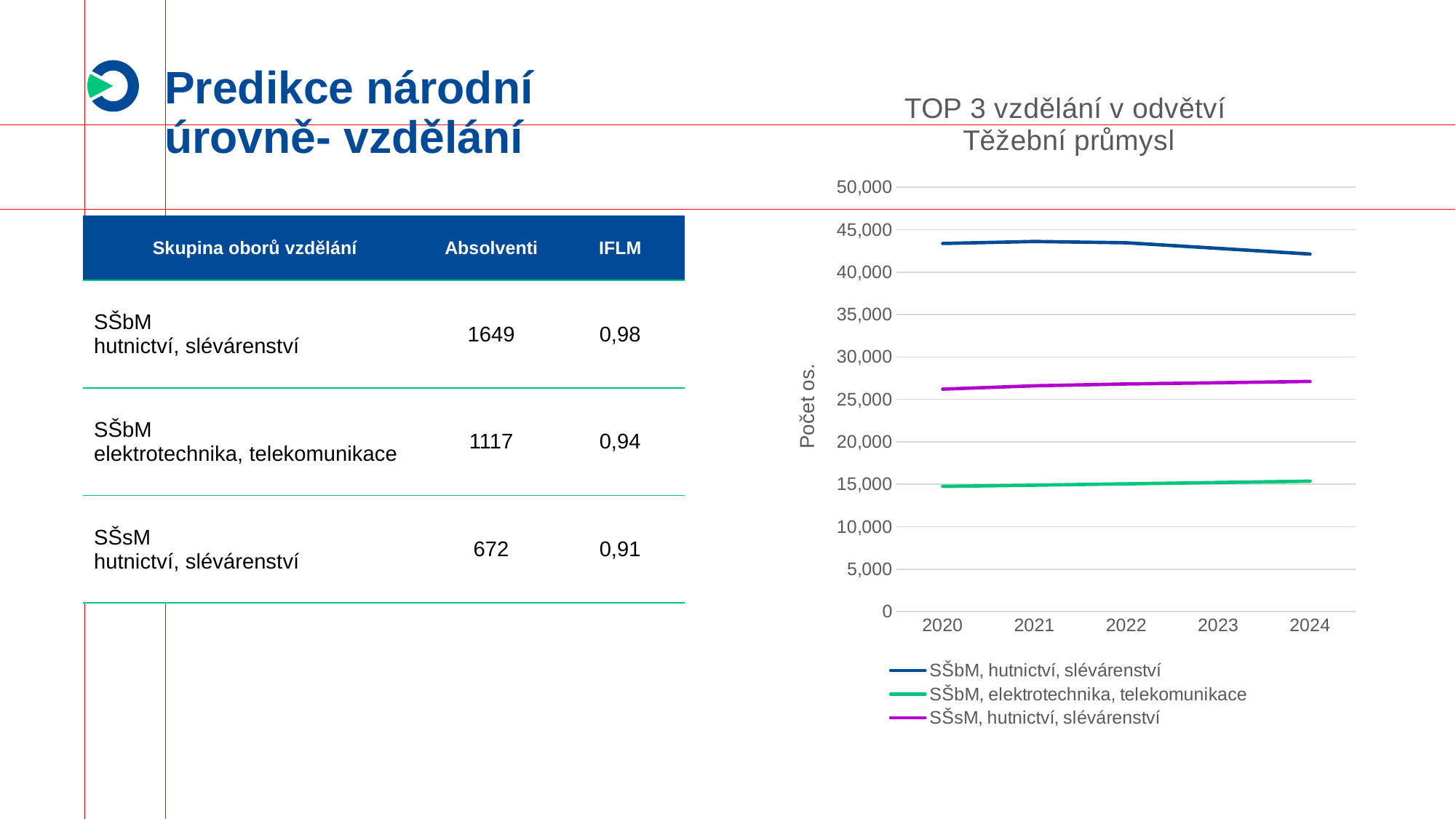
What is the label of the y axis of the chart? Počet os. Is the value for SŠbM, elektrotechnika, telekomunikace in 2022 greater or less than 20,000? less What is the title of the chart? TOP 3 vzdělání v odvětví Těžební průmysl Is the value for SŠbM, hutnictví, slévárenství in 2020 greater or less than 40,000? greater What kind of chart is shown on the slide? line chart Does the line for SŠsM, hutnictví, slévárenství rise or fall from 2020 to 2024? rise How many years are shown on the x axis of the chart? 5 Is the value for SŠsM, hutnictví, slévárenství in 2024 greater or less than 25,000? greater How many series does the chart legend list? 3 Which series has the lowest values across all years in the chart? SŠbM, elektrotechnika, telekomunikace Which series has the highest values across all years in the chart? SŠbM, hutnictví, slévárenství